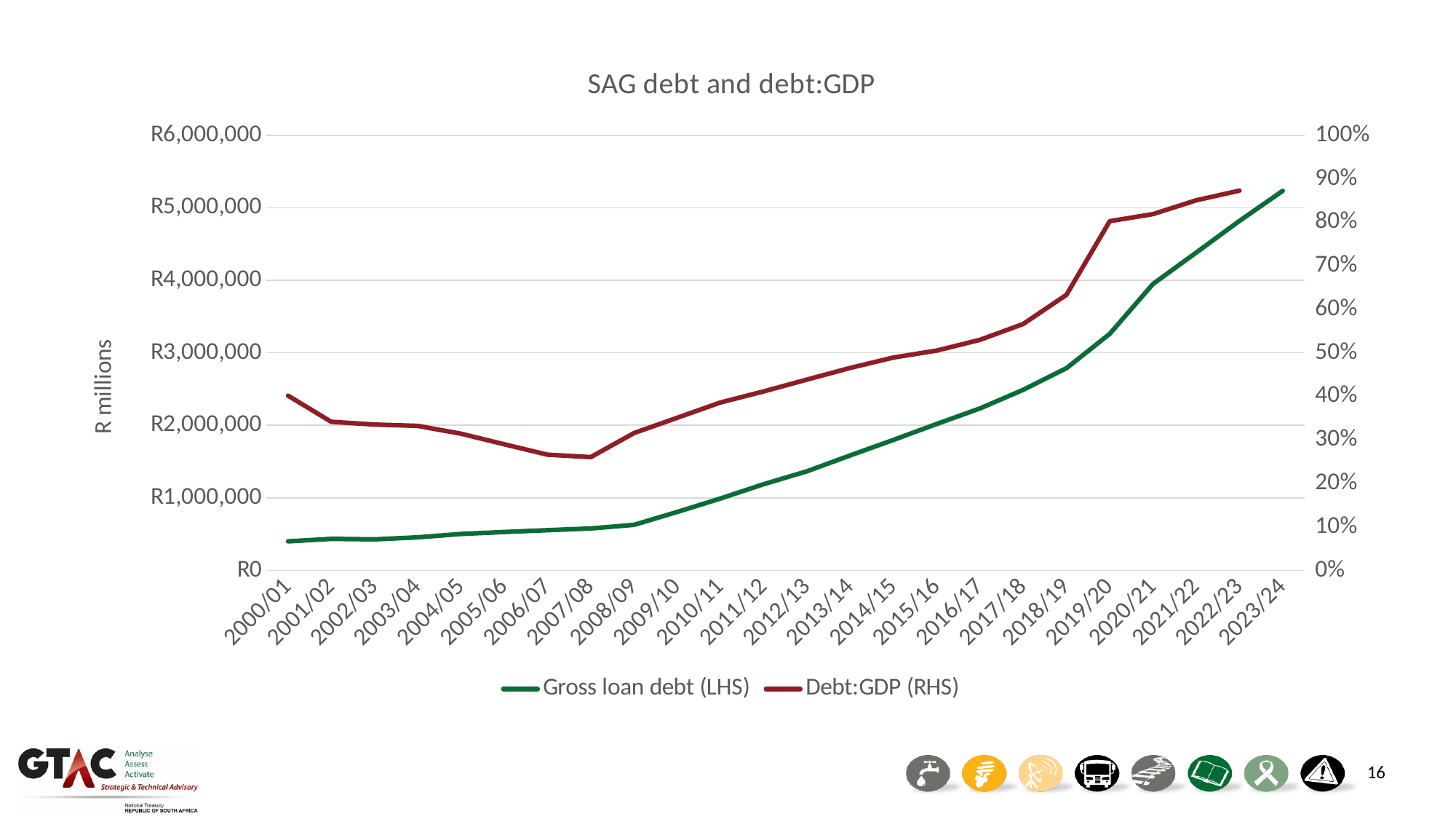
Is the Debt:GDP (RHS) value for 2019/20 greater or less than 70%? greater Is the Debt:GDP (RHS) value for 2007/08 greater or less than 30%? less Does Gross loan debt (LHS) generally rise or fall from 2000/01 to 2023/24? Rise In which year is Gross loan debt (LHS) at its highest? 2023/24 What kind of chart is shown on the slide? Line chart What is the label on the left vertical axis? R millions How many series does the legend list? 2 How many fiscal years are plotted along the x axis? 24 What is the title of the chart? SAG debt and debt:GDP In which year is Debt:GDP (RHS) at its highest? 2022/23 Is the Gross loan debt (LHS) value for 2023/24 greater or less than R5,000,000? greater Which year has the higher Debt:GDP (RHS) value, 2000/01 or 2008/09? 2000/01